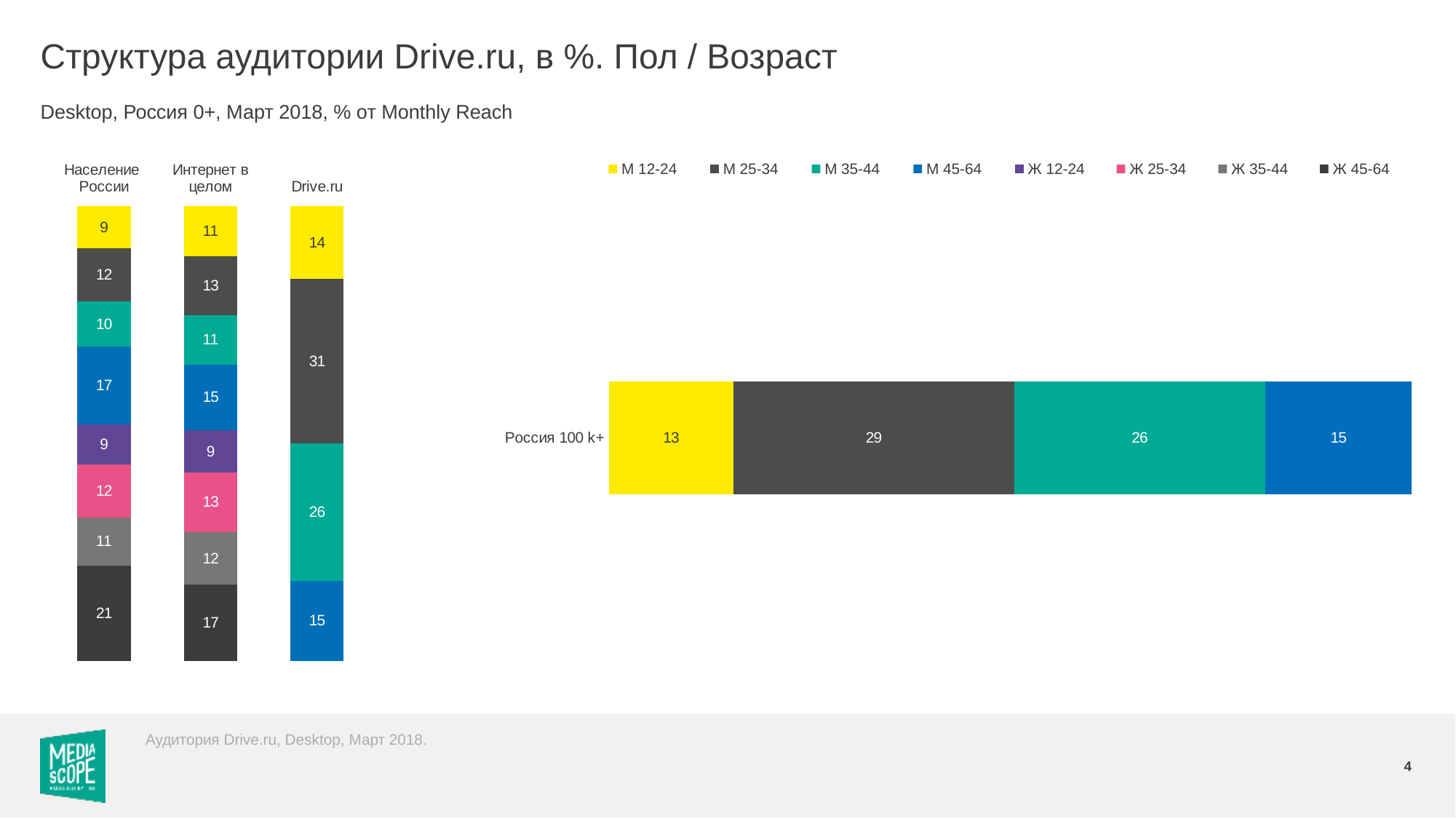
In the left stacked bar chart, what is the difference between the M 25-34 values for Drive.ru and Интернет в целом? 18 In the left stacked bar chart, what is the value of the M 45-64 segment for Интернет в целом? 15 In the left stacked bar chart, what is the value of the Ж 45-64 segment for Население России? 21 In the right horizontal bar chart (Россия 100 k+), what is the value of the M 12-24 segment? 13 In the right horizontal bar chart (Россия 100 k+), what is the value of the M 25-34 segment? 29 In the left stacked bar chart, which segment of the Население России bar is the largest? Ж 45-64 How many series does the legend list? 8 What type of chart is the chart on the right of the slide? Stacked bar chart In the left stacked bar chart, which segment of the Drive.ru bar is the largest? M 25-34 In the right horizontal bar chart (Россия 100 k+), which is larger: the M 35-44 segment or the M 45-64 segment? M 35-44 How many bars (categories) are shown in the left stacked bar chart? 3 In the left stacked bar chart, what is the value of the M 25-34 segment for Drive.ru? 31